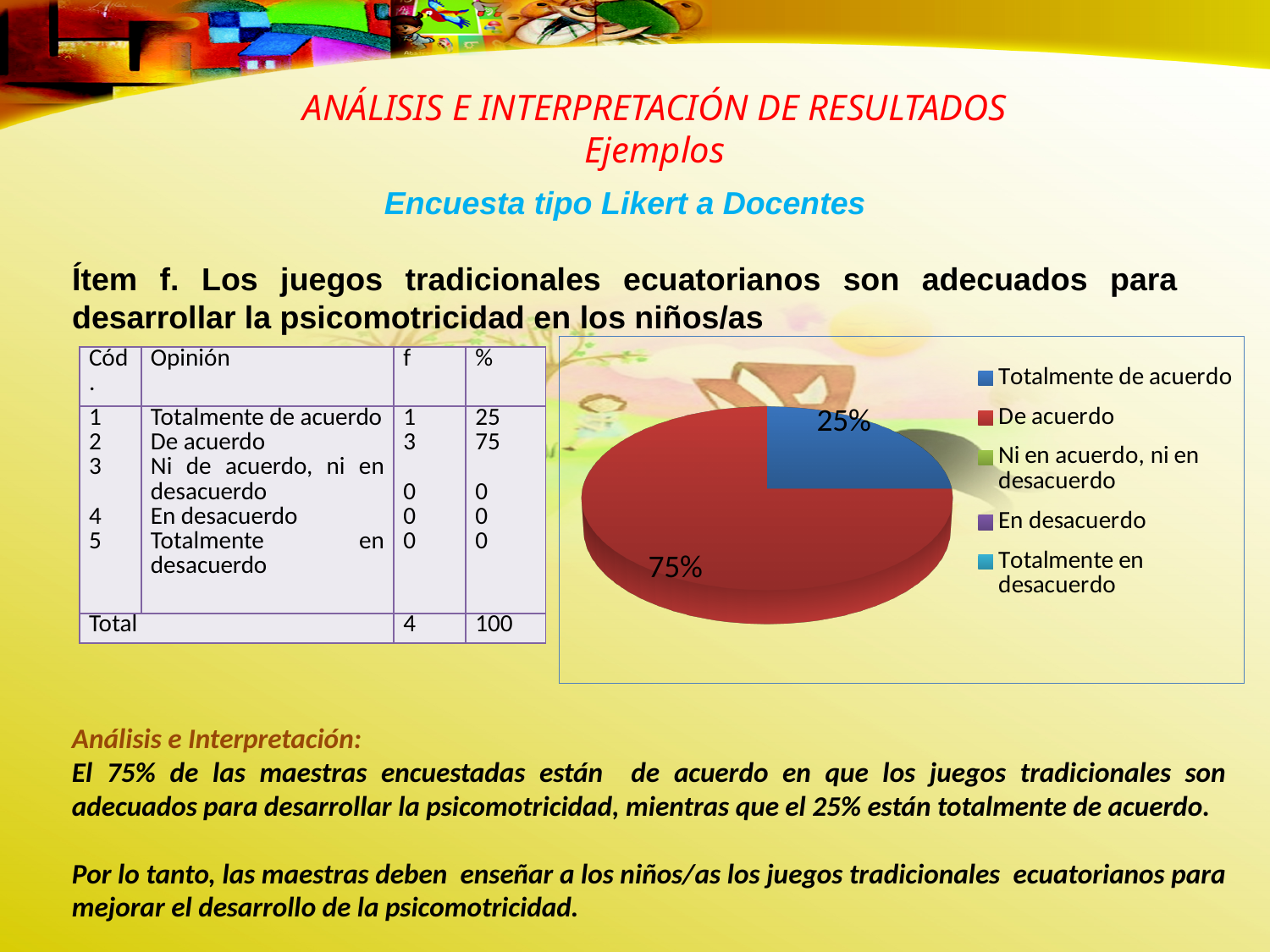
What share of the pie does the "Totalmente de acuerdo" slice represent? 25% What colour is the "De acuerdo" slice in the pie chart? red What share of the pie does the "De acuerdo" slice represent? 75% What colour is the "Totalmente de acuerdo" slice in the pie chart? blue What is the difference in percentage points between the "De acuerdo" slice and the "Totalmente de acuerdo" slice? 50 What kind of chart is shown on the slide? pie chart Which is larger in the pie chart, the "De acuerdo" slice or the "Totalmente de acuerdo" slice? De acuerdo How many slices with a visible percentage label are shown in the pie chart? 2 Is the share of the "De acuerdo" slice greater or less than 50%? greater How many entries does the legend of the pie chart list? 5 Which category has the largest slice in the pie chart? De acuerdo